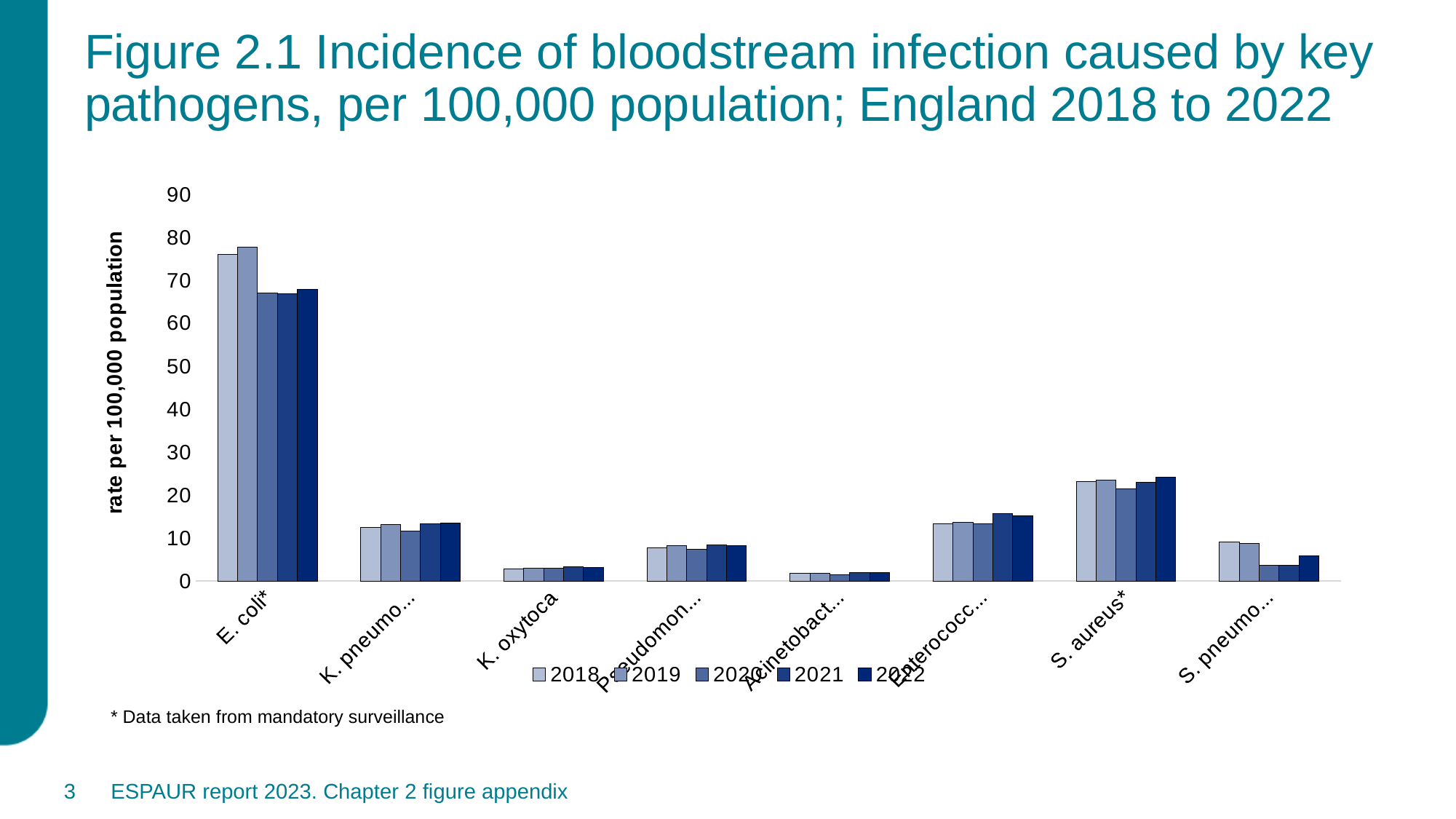
Is the 2021 value for Enterococc... greater or less than 10? greater Is the 2022 value for S. aureus* greater or less than 20? greater Which pathogen has the highest incidence of bloodstream infection across all years? E. coli* What kind of chart is shown on the slide? bar chart Which pathogen has the second-highest incidence in 2022, after E. coli*? S. aureus* What is the title of the y axis? rate per 100,000 population How many pathogen categories are shown on the x axis? 8 For E. coli*, which year has the larger value, 2019 or 2020? 2019 How many series does the legend list? 5 Is the 2020 value for K. oxytoca greater or less than 10? less Which pathogen has the lowest incidence of bloodstream infection across all years? Acinetobact...